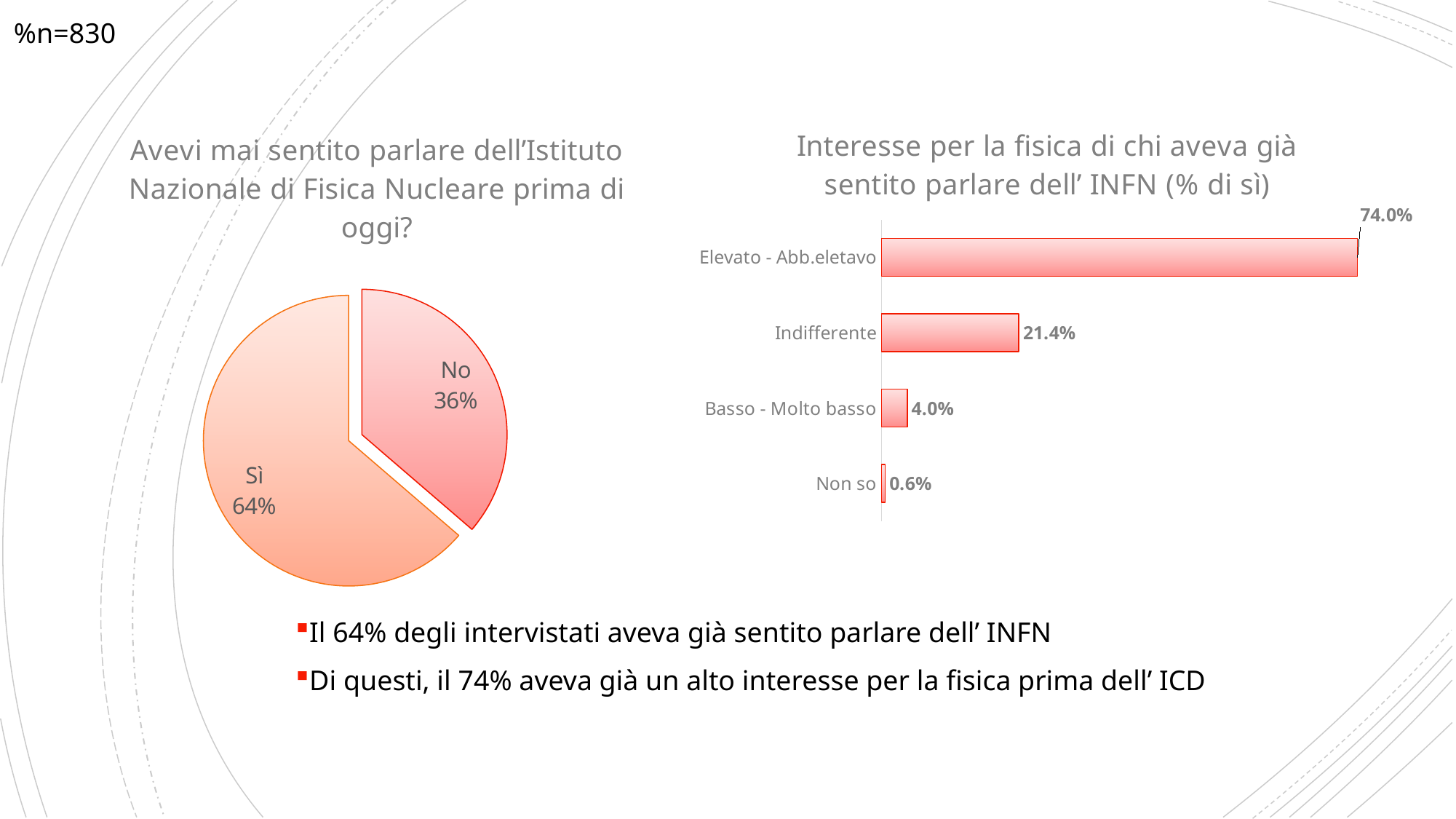
In the bar chart on the right, what is the value for "Basso - Molto basso"? 4.0% How many slices does the pie chart on the left have? 2 What kind of chart is the chart on the left of the slide? Pie chart In the bar chart on the right, what is the value for "Indifferente"? 21.4% In the bar chart on the right, which category has the lowest value? Non so In the pie chart on the left, what share of respondents answered "No"? 36% In the pie chart on the left, which slice is larger, "Sì" or "No"? Sì What kind of chart is the chart on the right of the slide? Bar chart In the pie chart on the left, what share of respondents answered "Sì"? 64% In the bar chart on the right, what is the difference between "Elevato - Abb.eletavo" and "Indifferente"? 52.6% How many categories does the bar chart on the right show? 4 In the bar chart on the right, what is the value for "Elevato - Abb.eletavo"? 74.0%